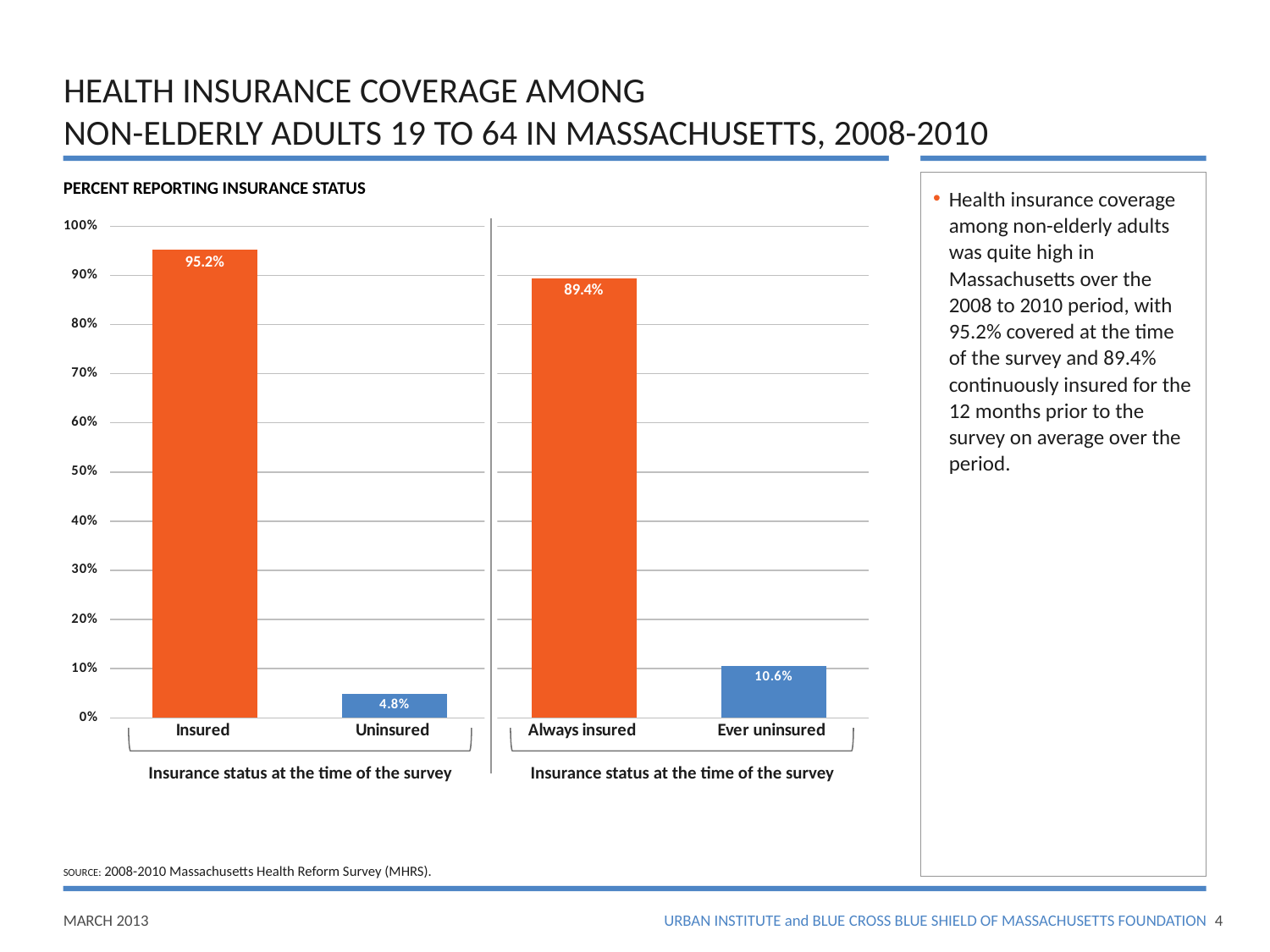
What percentage of non-elderly adults reported being Insured at the time of the survey? 95.2% Which is larger, the value for Insured or the value for Always insured? Insured How many categories are plotted on the chart? 4 What is the value shown for Ever uninsured? 10.6% Which category has the lowest value on the chart? Uninsured Is the value for Ever uninsured greater or less than 10%? greater What kind of chart is shown on the slide? Bar chart What is the difference between the Always insured and Ever uninsured percentages? 78.8 percentage points What is the difference between the Insured and Uninsured percentages? 90.4 percentage points Which category has the highest value on the chart? Insured What percentage of non-elderly adults reported being Uninsured at the time of the survey? 4.8% What is the value shown for Always insured? 89.4%